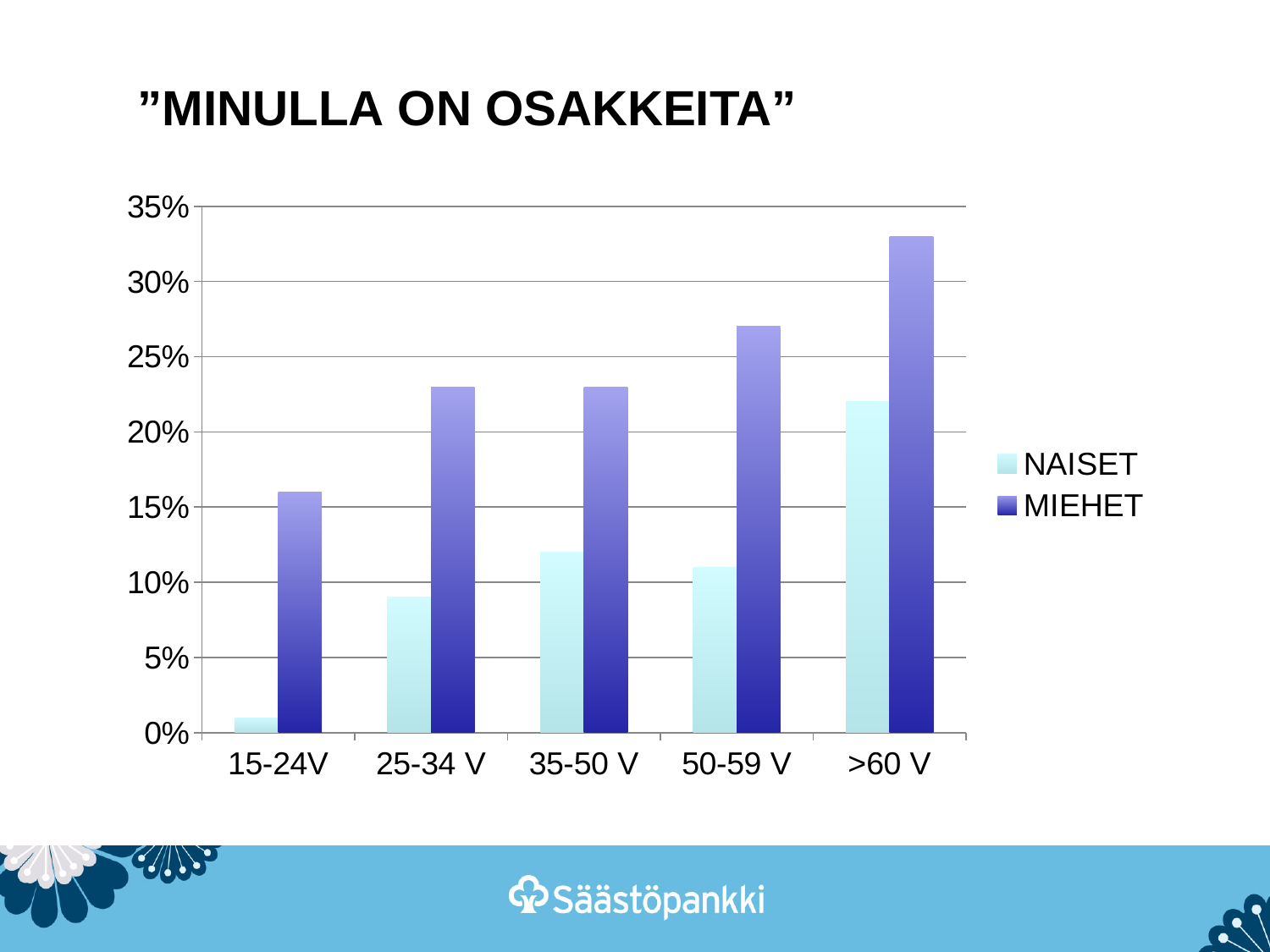
What is the title of the chart? "MINULLA ON OSAKKEITA" Is the MIEHET value for >60 V greater or less than 30%? greater What are the two series named in the legend? NAISET and MIEHET Which age group has the highest MIEHET value? >60 V Do the MIEHET values generally rise or fall from 15-24V to >60 V? rise How many series does the legend list? 2 Which age group has the lowest MIEHET value? 15-24V For the 35-50 V group, which is larger, NAISET or MIEHET? MIEHET How many age groups are shown on the x axis? 5 Is the NAISET value for 15-24V greater or less than 5%? less What kind of chart is shown on the slide? bar chart Which age group has the lowest NAISET value? 15-24V